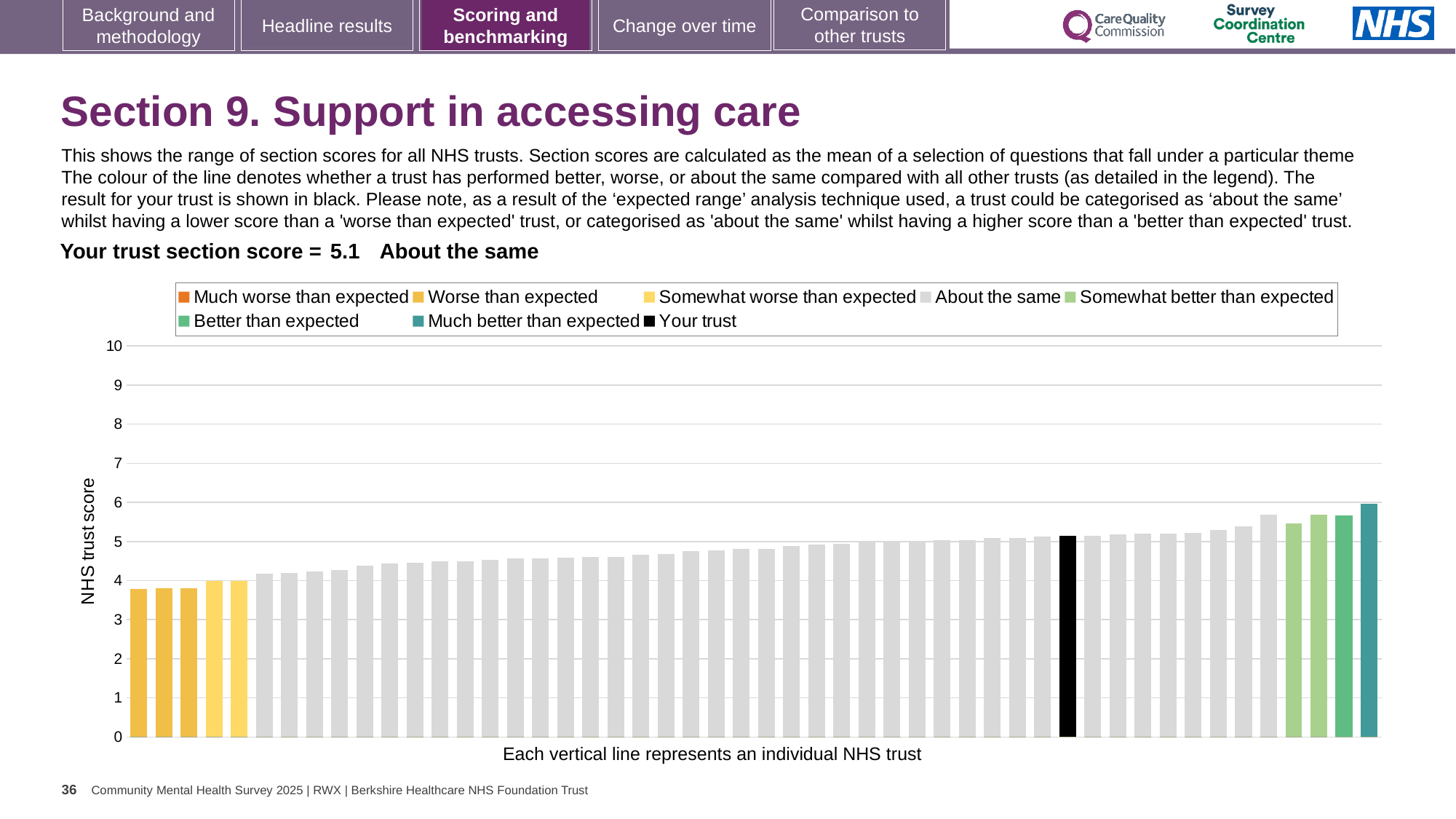
Is the value of the highest bar greater or less than 5? greater Which legend category does the highest bar on the chart belong to? Much better than expected Is the value of the lowest bar greater or less than 4? less Which legend category do the lowest bars on the chart belong to? Worse than expected How many entries does the chart legend list? 8 What is the label on the y axis of the chart? NHS trust score Is the value for your trust (the black bar) greater or less than 5? greater Is the value for your trust (the black bar) larger or smaller than the value of the highest bar? smaller What kind of chart is shown on the slide? bar chart Do the bar values rise or fall from left to right along the x axis? rise What is the section score for your trust shown on the slide? 5.1 What colour is the bar representing your trust? black